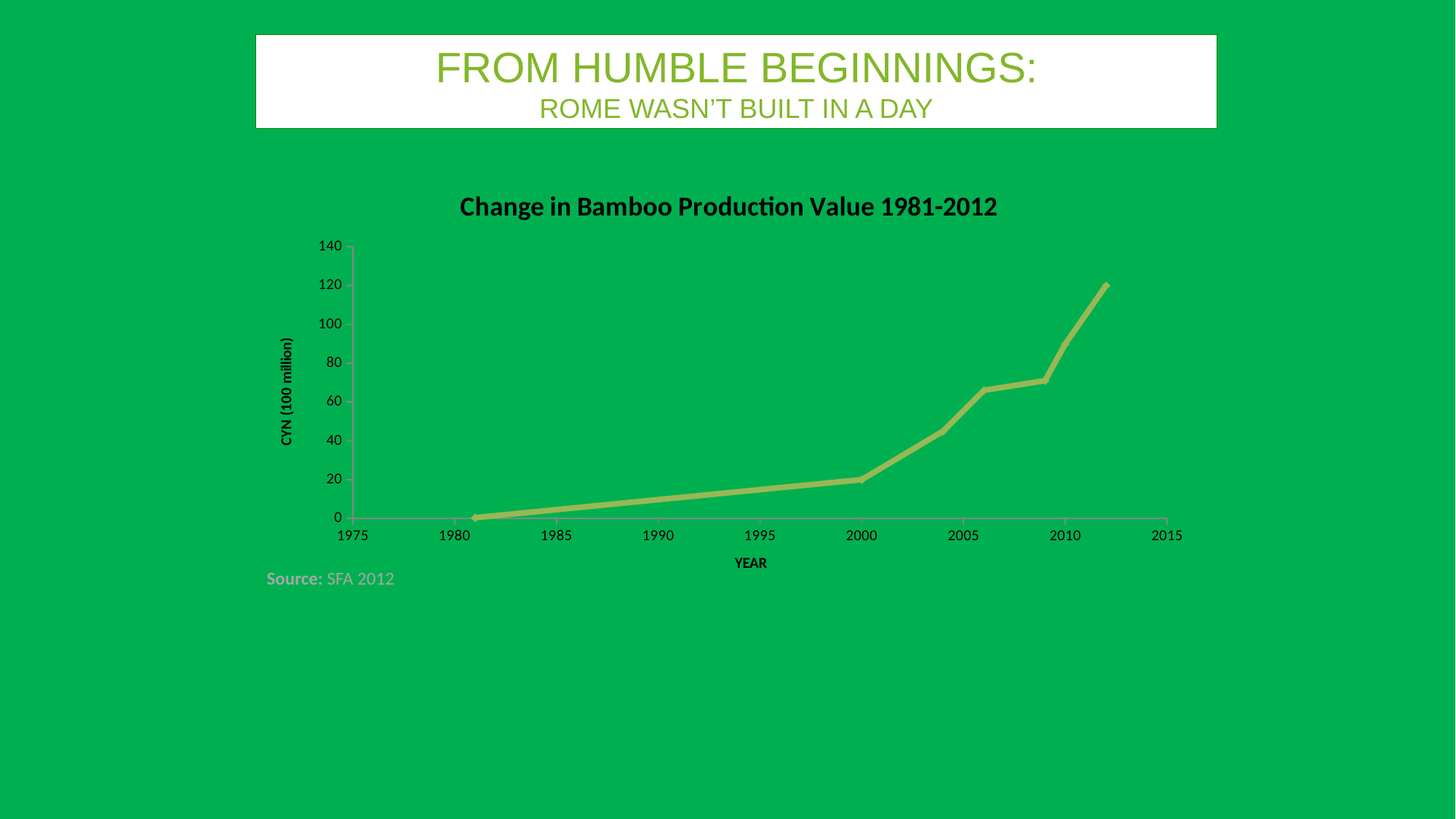
Is the value for 2012 greater or less than 100? greater Which is larger, the value for 2009 or the value for 2004? 2009 What kind of chart is shown on the slide? line chart How many data points are plotted on the line? 7 Is the value for 2000 greater or less than 40? less Is the value for 2006 greater or less than 60? greater Do the values rise or fall from 1981 to 2012? rise Which year has the highest bamboo production value? 2012 What is the title of the chart? Change in Bamboo Production Value 1981-2012 What is the label of the vertical axis? CYN (100 million) Which year has the lowest bamboo production value? 1981